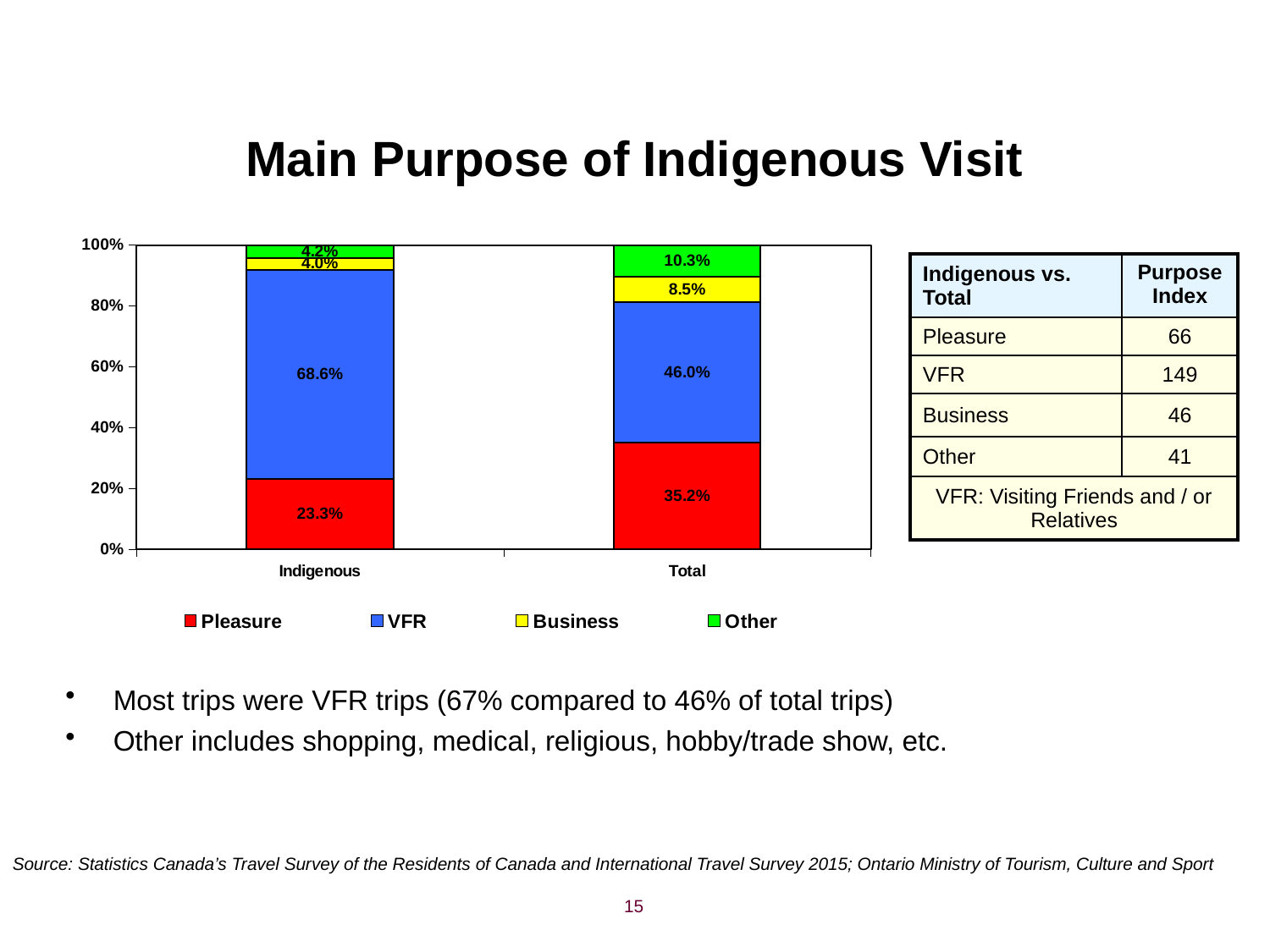
How many categories are shown on the x axis? 2 Which is larger, the Pleasure share for Indigenous or the Pleasure share for Total? Total What colour represents VFR in the chart? Blue Which series has the largest share in the Indigenous bar? VFR What kind of chart is shown on the slide? Stacked bar chart What is the difference between the VFR share for Indigenous and the VFR share for Total? 22.6% Which series has the smallest share in the Total bar? Business What is the Pleasure share for the Total bar? 35.2% How many series does the legend list? 4 What is the VFR share for the Indigenous bar? 68.6% What is the Business share for the Total bar? 8.5% What is the Other share for the Indigenous bar? 4.2%